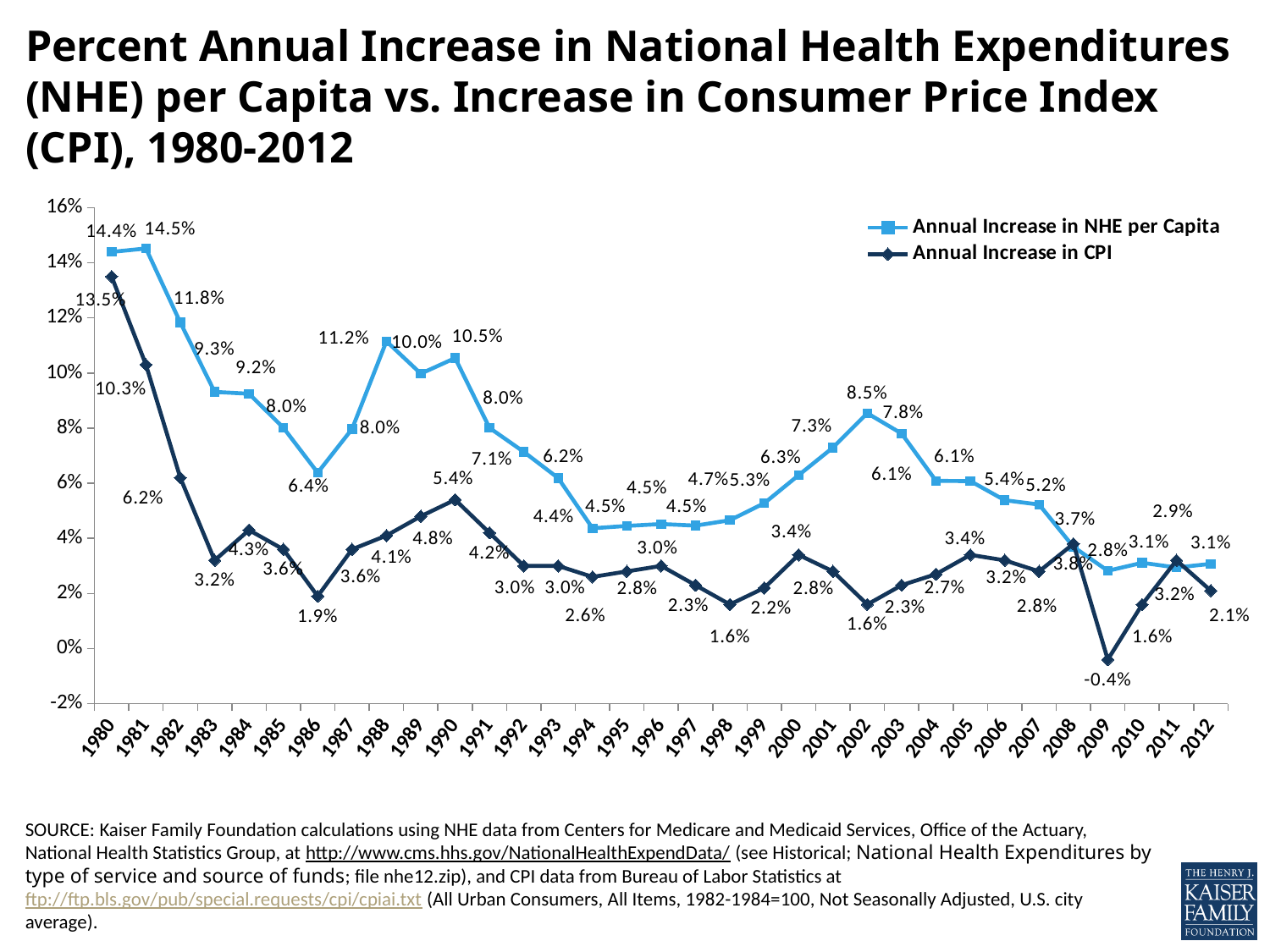
In which year was the annual increase in CPI lowest? 2009 How many series does the legend list? 2 How many years are plotted along the x axis? 33 What kind of chart is shown on the slide? Line chart Which colour is used for the Annual Increase in NHE per Capita line? Light blue Overall, does the annual increase in NHE per capita rise or fall from 1980 to 2012? Fall What was the annual increase in CPI in 2009? -0.4% What is the difference between the annual increase in NHE per capita and the annual increase in CPI in 2002? 6.9 percentage points What was the annual increase in NHE per capita in 1988? 11.2% What was the annual increase in NHE per capita in 2002? 8.5% In which year was the annual increase in NHE per capita highest? 1981 Which was larger in 1986, the annual increase in NHE per capita or the annual increase in CPI? Annual increase in NHE per capita